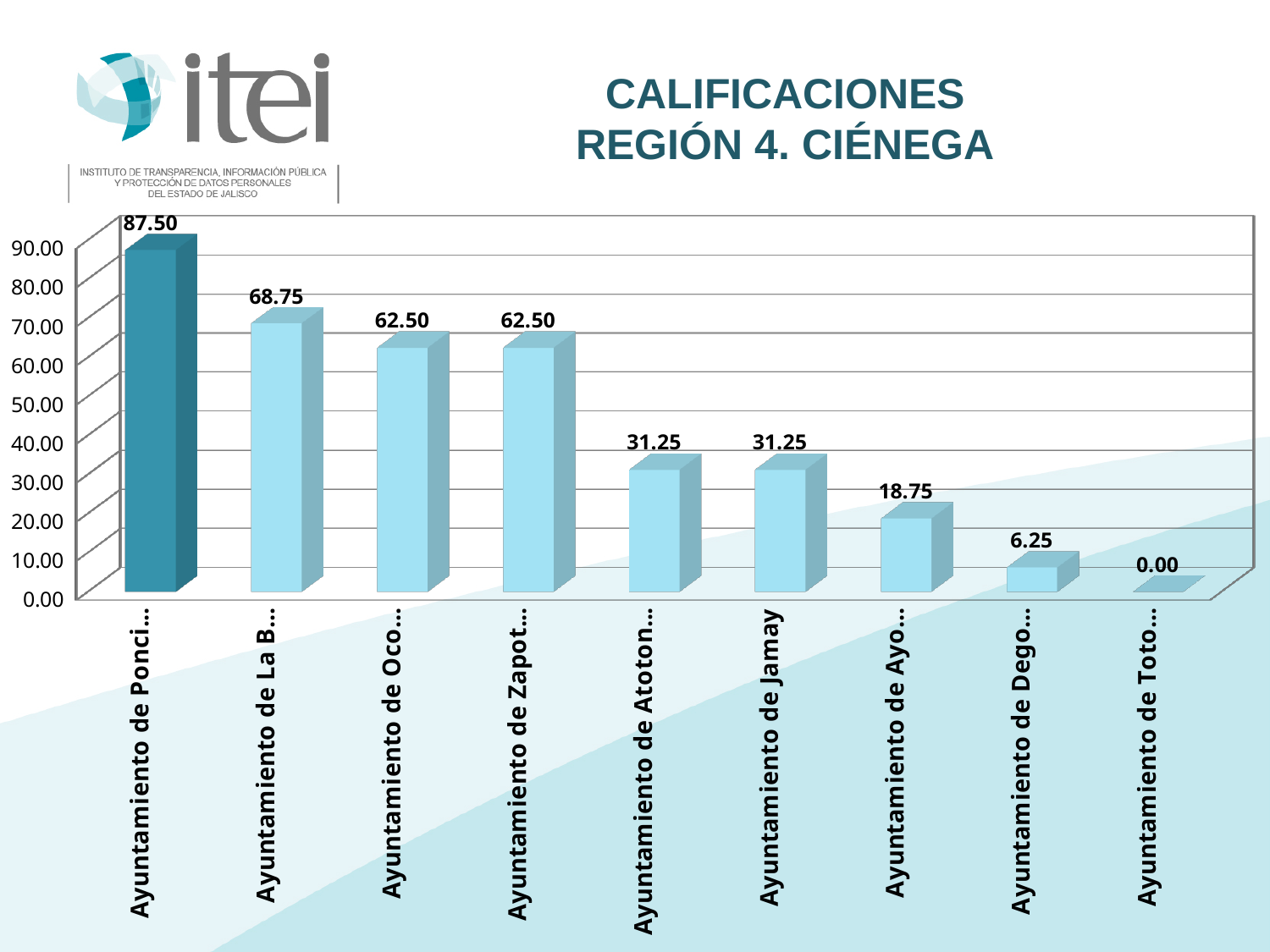
What value is shown for the first bar on the left, labelled "Ayuntamiento de Ponci…"? 87.50 Which category has the lowest value in the chart? Ayuntamiento de Toto… How many categories (bars) are shown in the chart? 9 What is the difference between the value for the bar labelled "Ayuntamiento de La B…" and the value for Ayuntamiento de Jamay? 37.50 What kind of chart is shown on the slide? Bar chart What is the title shown on the slide above the chart? CALIFICACIONES REGIÓN 4. CIÉNEGA Which is larger: the value for the bar labelled "Ayuntamiento de Oco…" or the value for Ayuntamiento de Jamay? Ayuntamiento de Oco… What value is shown for Ayuntamiento de Jamay? 31.25 Do the values rise or fall from left to right along the x axis? Fall What value is shown for the bar labelled "Ayuntamiento de Dego…"? 6.25 Which category has the highest value in the chart? Ayuntamiento de Ponci… What value is shown for the bar labelled "Ayuntamiento de Ayo…"? 18.75